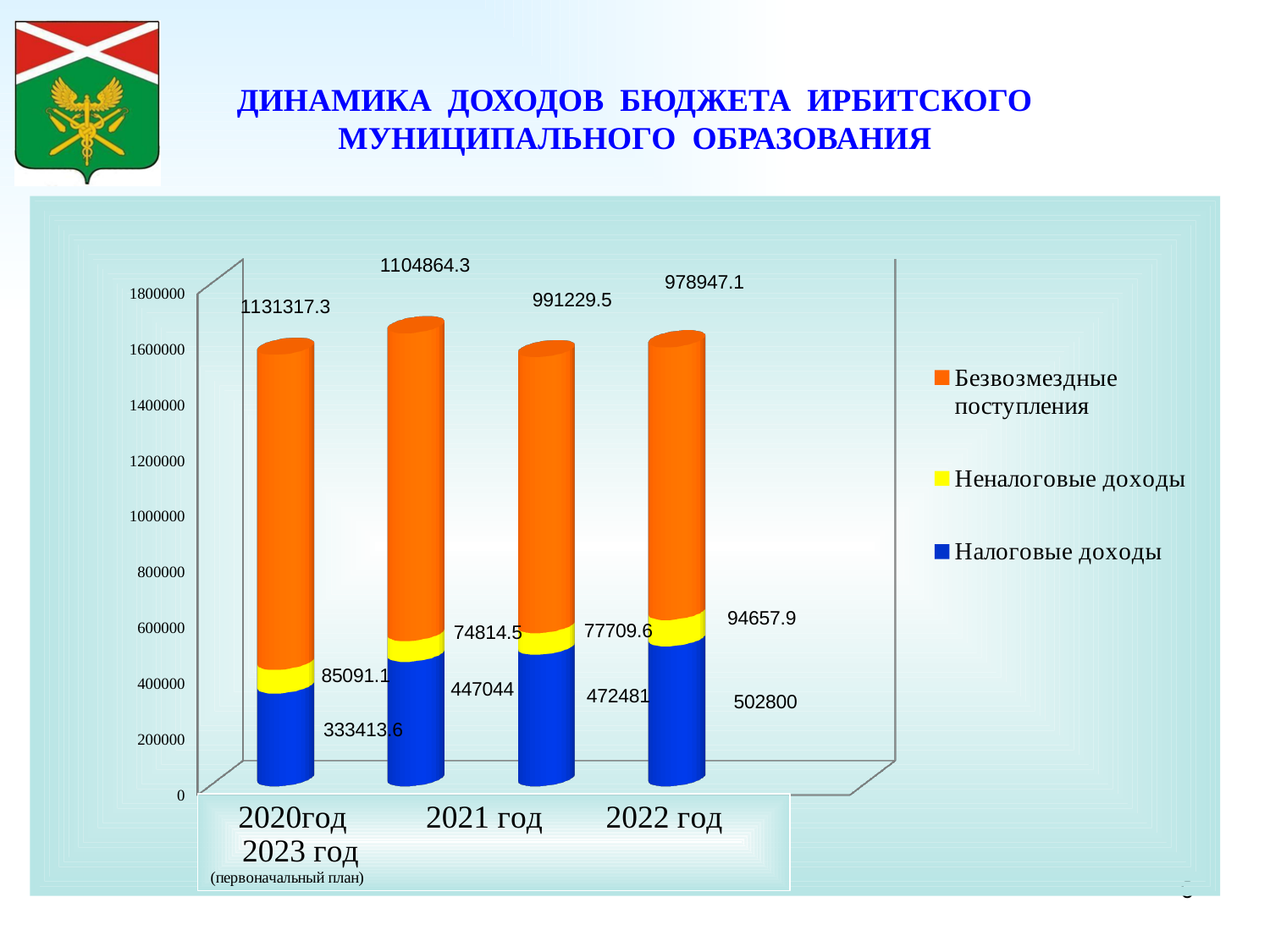
Do Налоговые доходы rise or fall from 2020год to 2023 год? Rise What is the value of Неналоговые доходы for 2023 год (первоначальный план)? 94657.9 What is the value of Безвозмездные поступления for 2020год? 1131317.3 In which year are Неналоговые доходы the lowest? 2021 год How many series does the legend list? 3 How many years (categories) are shown on the x axis? 4 Which is larger: Безвозмездные поступления in 2021 год or in 2022 год? 2021 год What is the total of the stacked bar for 2022 год? 1541420.1 What is the value of Налоговые доходы for 2021 год? 447044 What is the difference between Налоговые доходы in 2023 год and in 2022 год? 30319 In which year are Безвозмездные поступления the highest? 2020год What kind of chart is shown on the slide? Stacked bar chart